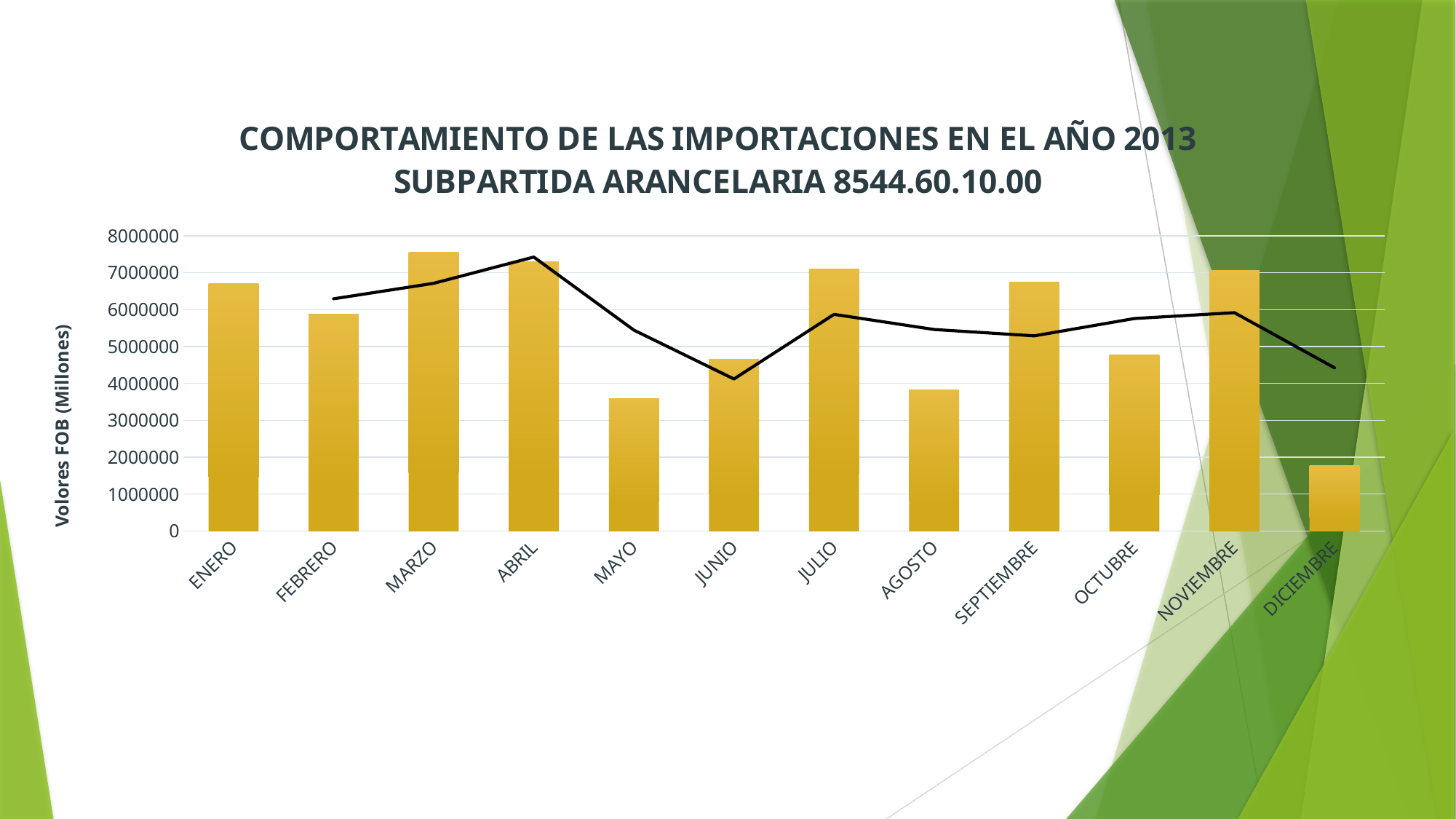
Is the value for OCTUBRE greater or less than 5000000? less Which month has the highest bar in the chart? MARZO Is the value for MAYO greater or less than 4000000? less What is the title of the chart? COMPORTAMIENTO DE LAS IMPORTACIONES EN EL AÑO 2013 SUBPARTIDA ARANCELARIA 8544.60.10.00 What is the label on the vertical axis of the chart? Volores FOB (Millones) Is the value for DICIEMBRE greater or less than 2000000? less How many months are shown on the x axis of the chart? 12 What kind of chart is shown on the slide? Bar chart Which month has the lowest bar in the chart? DICIEMBRE Which is larger, the value for MAYO or the value for JUNIO? JUNIO Which is larger, the value for ENERO or the value for FEBRERO? ENERO